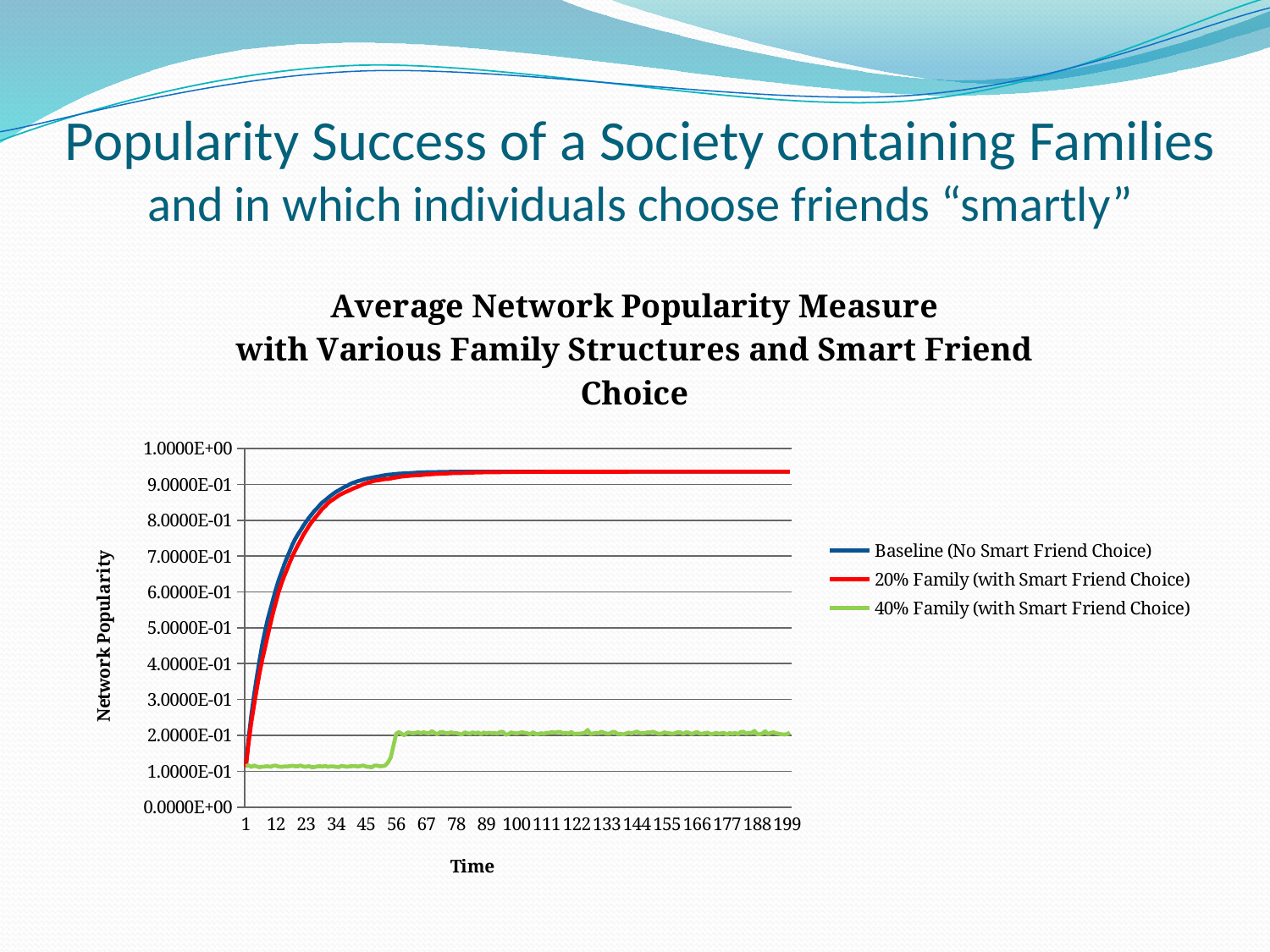
Which colour is used for the 40% Family (with Smart Friend Choice) series? Green At time 199, is the value for Baseline (No Smart Friend Choice) greater or less than 9.0000E-01? greater At time 199, which is larger: the value for Baseline (No Smart Friend Choice) or the value for 40% Family (with Smart Friend Choice)? Baseline (No Smart Friend Choice) At time 34, is the value for 20% Family (with Smart Friend Choice) greater or less than 5.0000E-01? greater At time 199, is the value for 40% Family (with Smart Friend Choice) greater or less than 3.0000E-01? less What is the title of the chart? Average Network Popularity Measure with Various Family Structures and Smart Friend Choice How many series does the legend list? 3 Which series has the lowest values across the whole time range? 40% Family (with Smart Friend Choice) Does the 20% Family (with Smart Friend Choice) series rise or fall over the first part of the time axis before levelling off? Rise What kind of chart is shown on the slide? Line chart Does the Baseline (No Smart Friend Choice) series rise or fall between time 1 and time 56? Rise